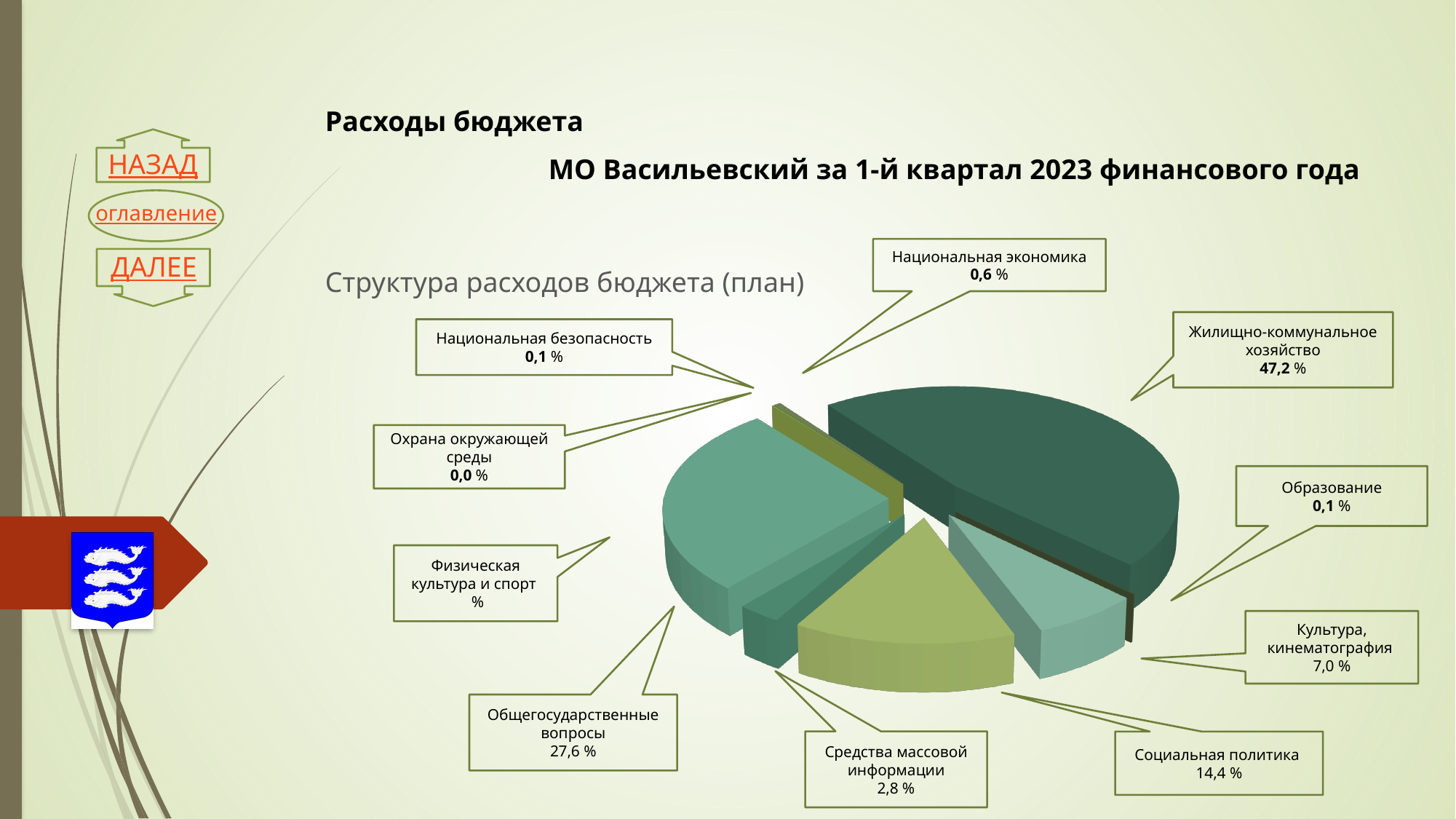
What share of the budget expenditure is Культура, кинематография? 7,0 % What share of the budget expenditure is Средства массовой информации? 2,8 % What kind of chart is shown on the slide? pie chart What is the difference between the shares of Жилищно-коммунальное хозяйство and Общегосударственные вопросы? 19,6 % What share of the budget expenditure is Жилищно-коммунальное хозяйство? 47,2 % What share of the budget expenditure is Национальная экономика? 0,6 % What is the title of the chart? Структура расходов бюджета (план) What share of the budget expenditure is Общегосударственные вопросы? 27,6 % Which category has the largest share of the budget expenditure? Жилищно-коммунальное хозяйство Which is larger, the share of Социальная политика or the share of Культура, кинематография? Социальная политика What share of the budget expenditure is Социальная политика? 14,4 %